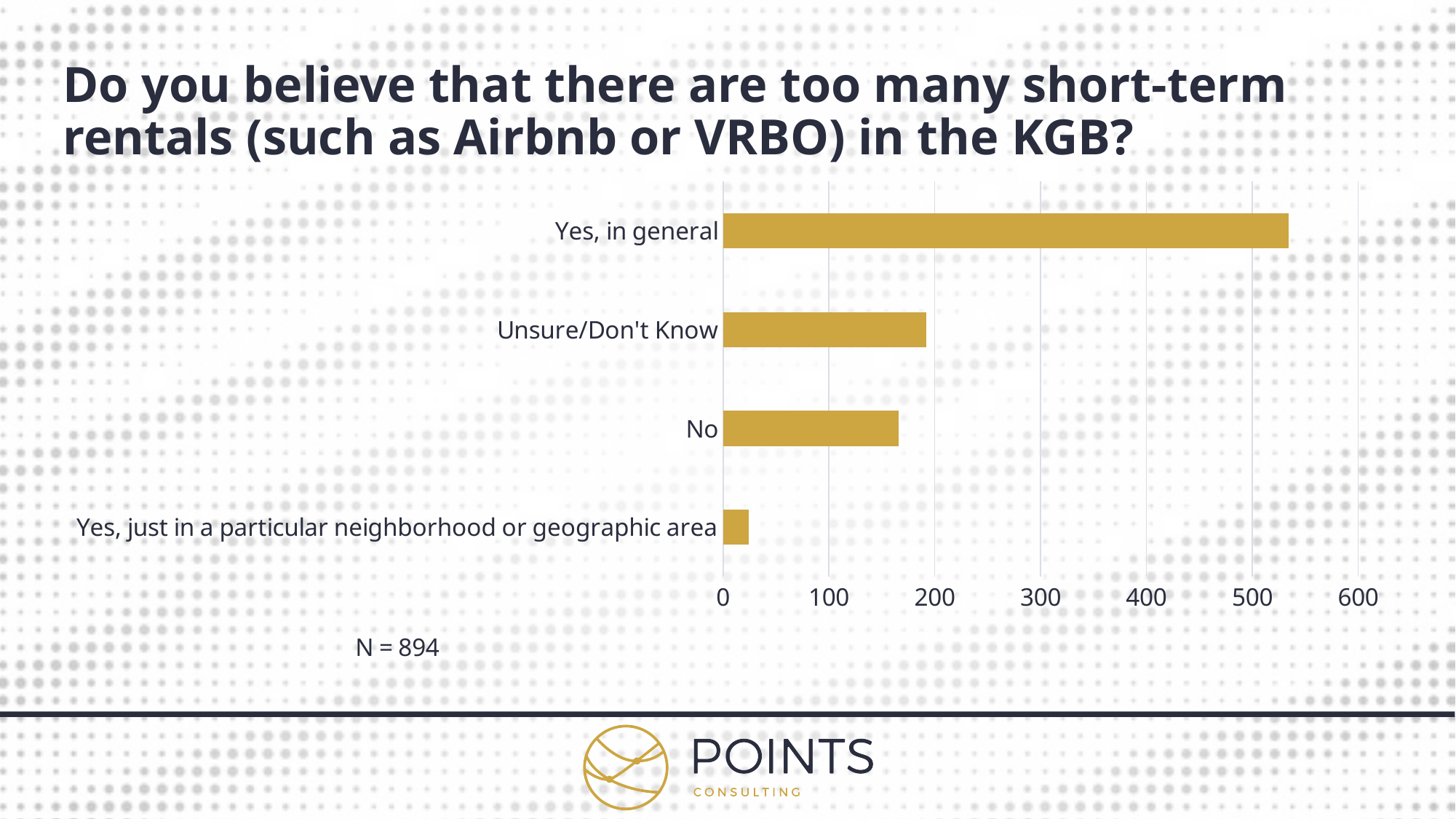
Which is larger, the value for "Unsure/Don't Know" or the value for "No"? Unsure/Don't Know What kind of chart is shown on the slide? bar chart Is the value for "Yes, in general" greater or less than 500? greater Which response category has the highest value? Yes, in general Is the value for "No" greater or less than 200? less What is the sample size (N) stated on the slide? N = 894 Is the value for "Yes, just in a particular neighborhood or geographic area" greater or less than 100? less Which response category has the lowest value? Yes, just in a particular neighborhood or geographic area What is the title of the chart on the slide? Do you believe that there are too many short-term rentals (such as Airbnb or VRBO) in the KGB? How many response categories are shown in the chart? 4